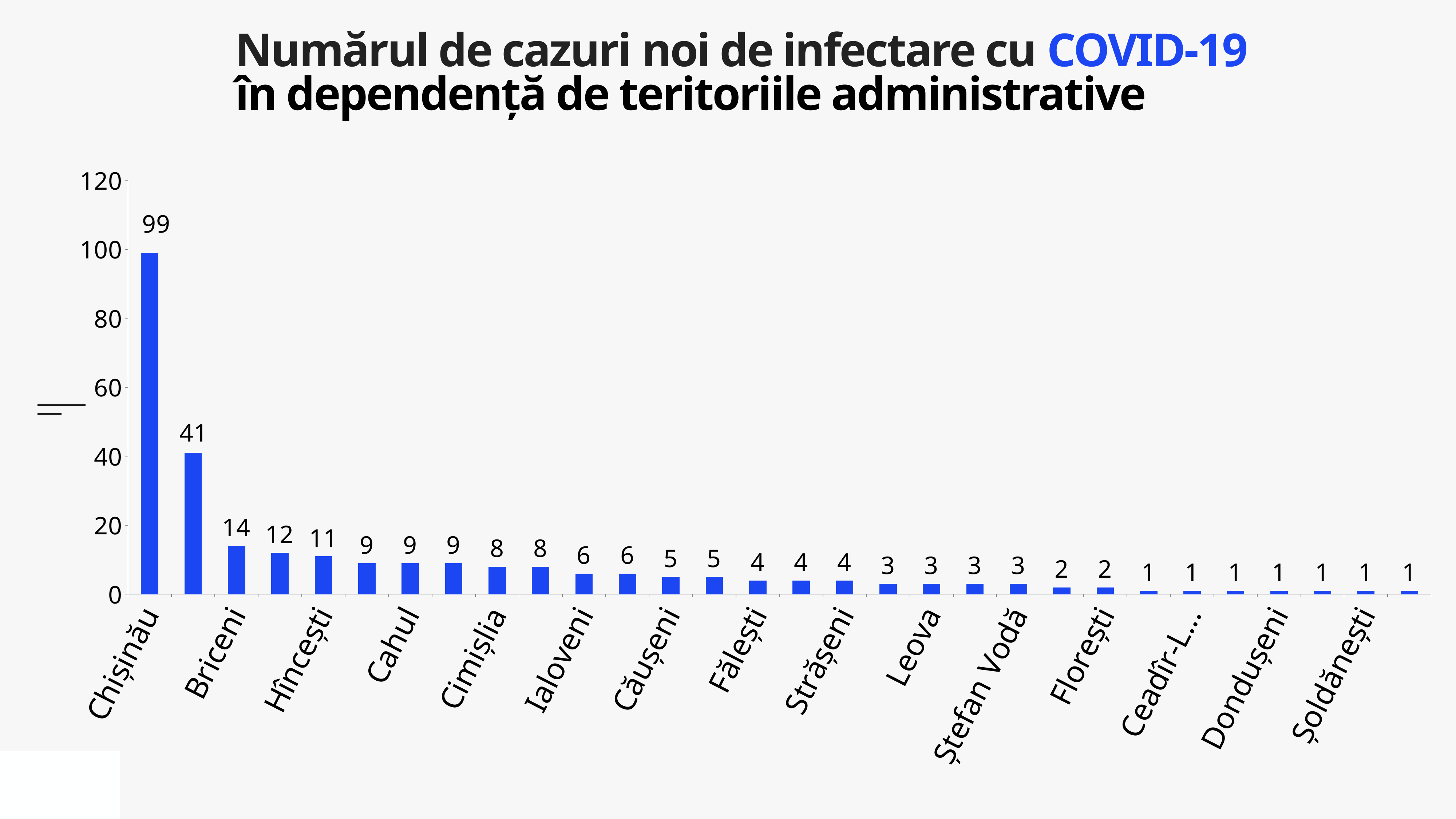
What is the value shown for Cahul? 9 What is the value shown for Căușeni? 5 What kind of chart is shown on the slide? bar chart What is the value shown for Șoldănești? 1 What is the number of new COVID-19 cases for Chișinău? 99 Which administrative territory has the highest number of new cases? Chișinău Is the value for Chișinău greater or less than 80? greater What is the value shown for Ialoveni? 6 What is the difference between the tallest bar and the second tallest bar? 58 Which is larger, the value for Cimișlia or the value for Leova? Cimișlia Do the values rise or fall moving from left to right along the x axis? fall What is the value shown for Florești? 2